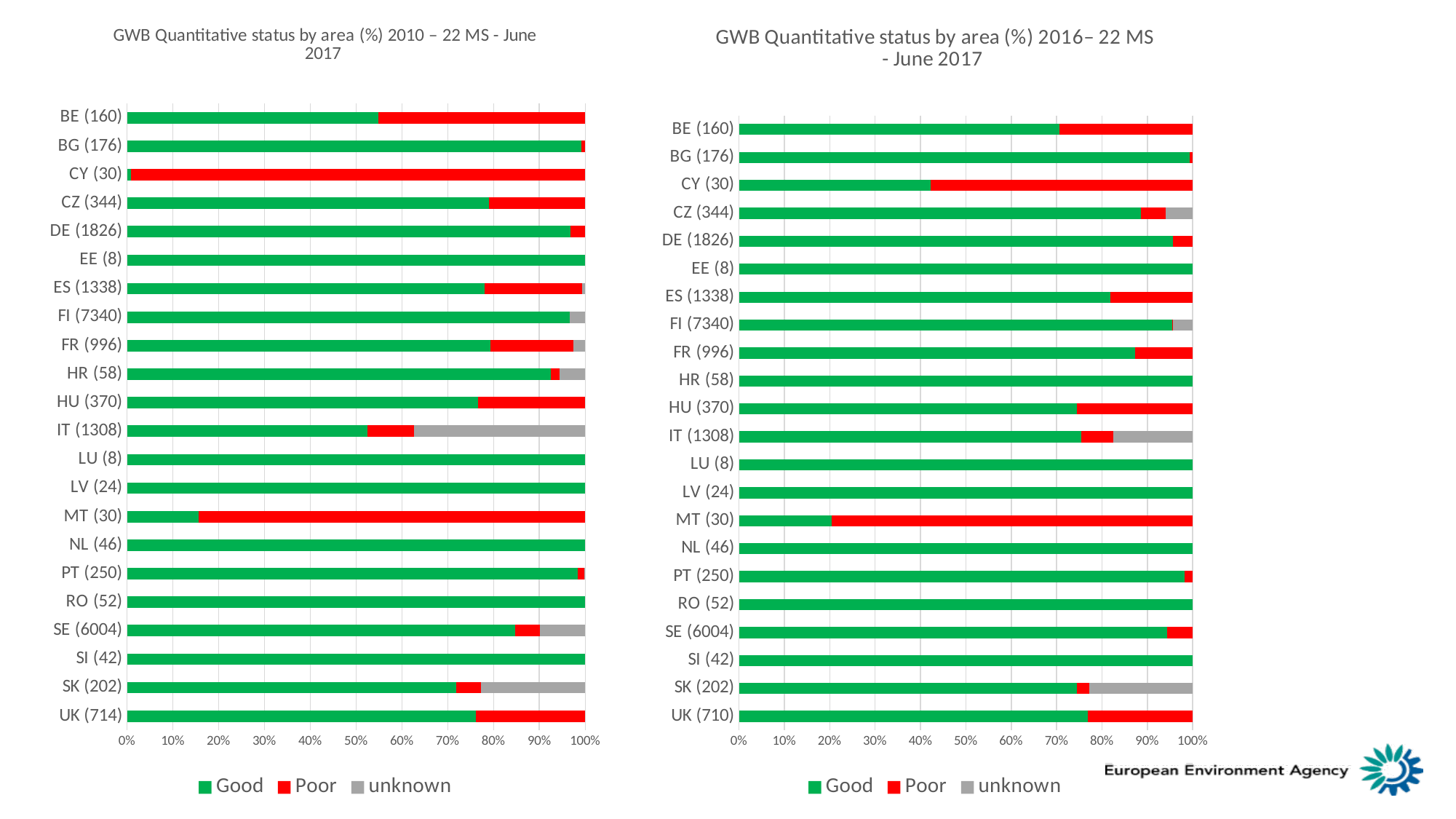
What kind of chart is the left chart, 'GWB Quantitative status by area (%) 2010 – 22 MS - June 2017'? Stacked bar chart How many countries are listed on the left chart (2010)? 22 On the left chart (2010), which country has the smallest Good share? CY (30) On the right chart (2016), which country has the smallest Good share? MT (30) On the right chart (2016), which has the larger Good share, MT (30) or HU (370)? HU (370) What are the three legend entries on the right chart (2016)? Good, Poor, unknown On the left chart (2010), which has the larger Good share, BE (160) or CY (30)? BE (160) On the right chart (2016), is the Good share for BE (160) greater or less than 60%? greater On the right chart (2016), is the Good share for CY (30) greater or less than 50%? less On the left chart (2010), is the Good share for BE (160) greater or less than 50%? greater How many series does the legend of the right chart (2016) list? 3